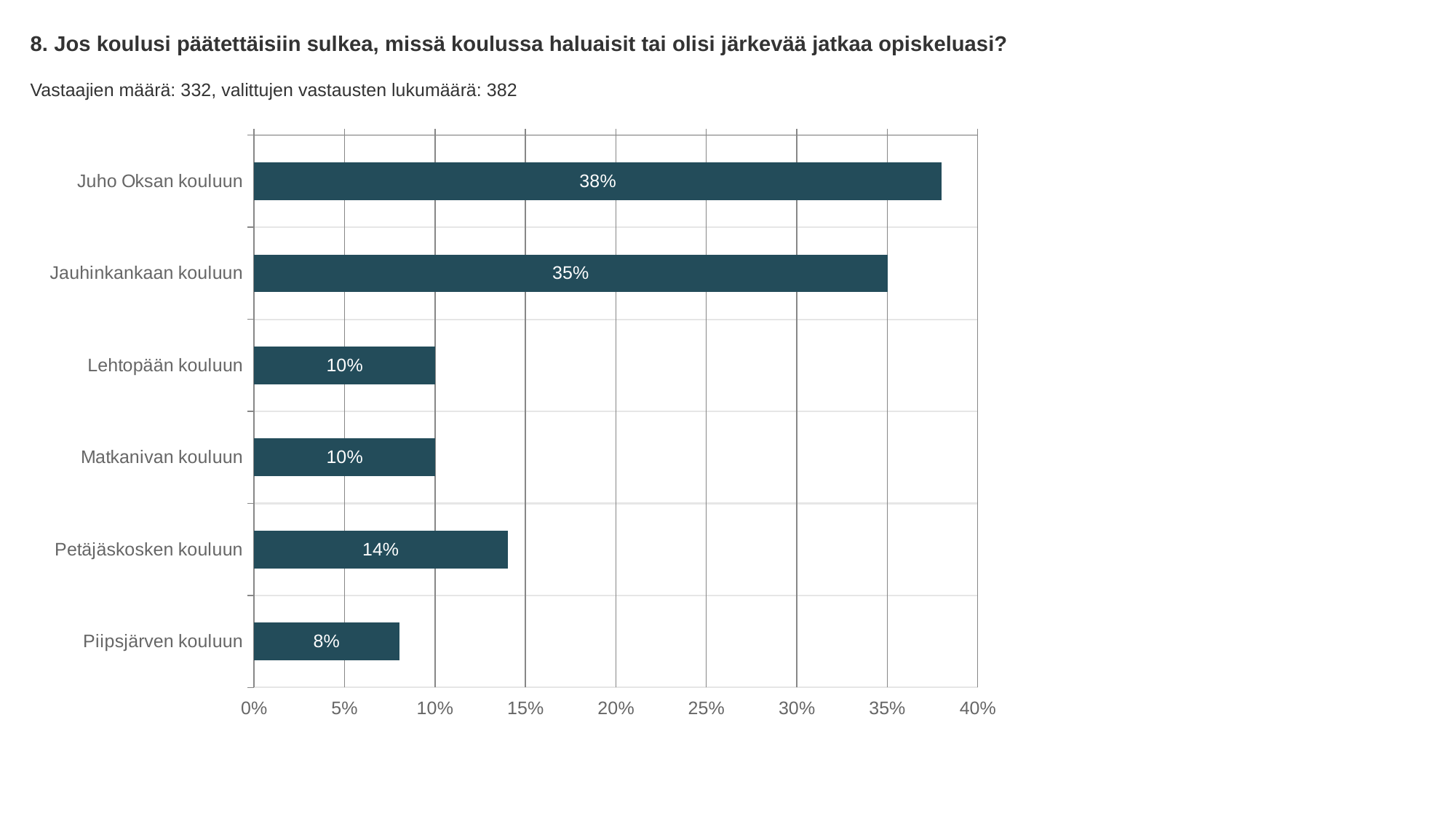
What is the value shown for Piipsjärven kouluun? 8% What is the number of respondents stated on the slide? 332 Which has a larger value, Petäjäskosken kouluun or Lehtopään kouluun? Petäjäskosken kouluun What percentage of respondents chose Juho Oksan kouluun? 38% Which school has the highest percentage? Juho Oksan kouluun What is the difference between the values for Petäjäskosken kouluun and Piipsjärven kouluun? 6% What is the difference between the values for Juho Oksan kouluun and Jauhinkankaan kouluun? 3% Which school has the lowest percentage? Piipsjärven kouluun What is the value shown for Petäjäskosken kouluun? 14% How many schools are shown in the chart? 6 Is the value for Jauhinkankaan kouluun greater or less than 30%? greater What kind of chart is shown on the slide? Bar chart